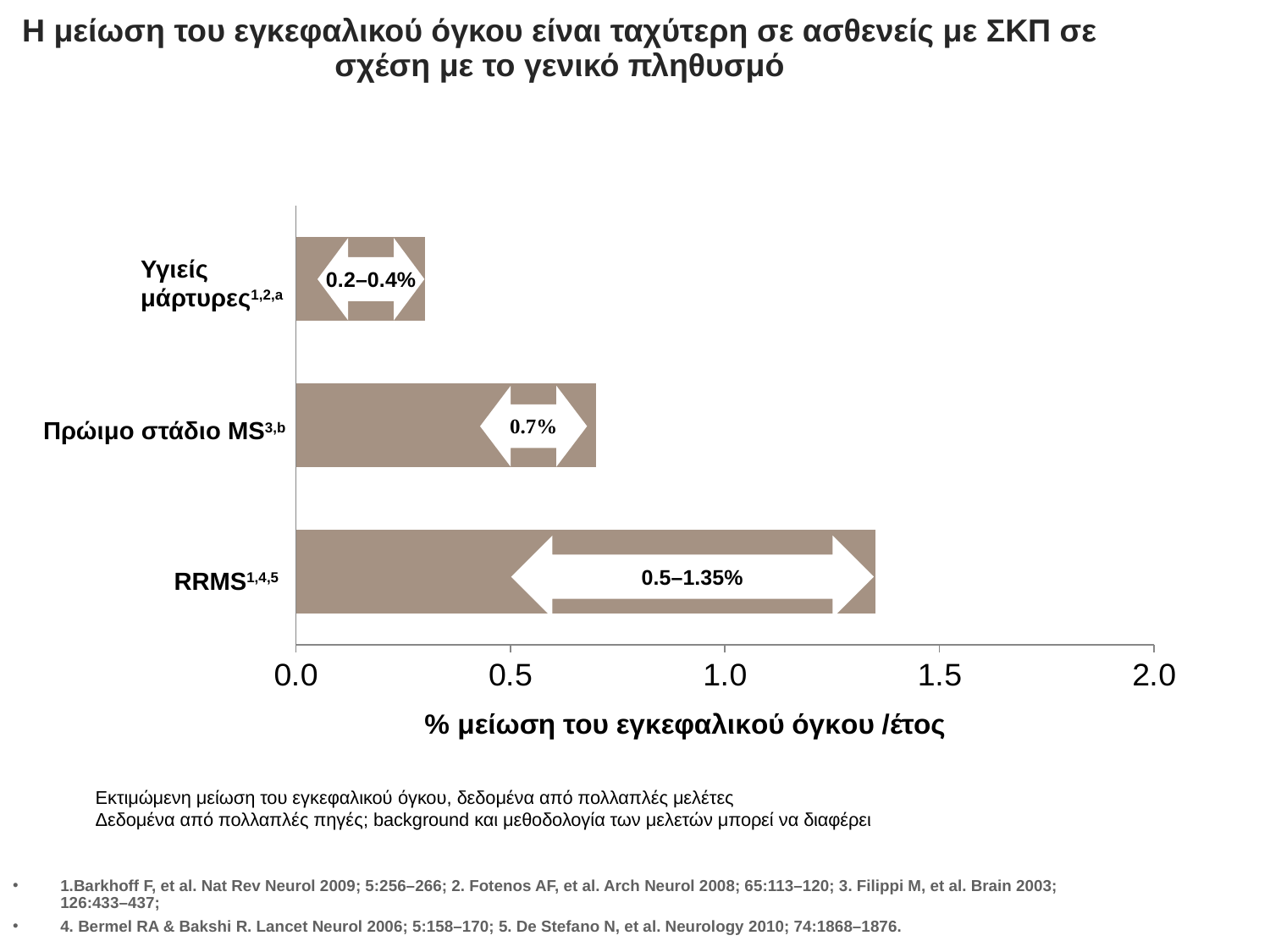
What is the data label shown on the bar for RRMS? 0.5–1.35% Which category has the shortest bar? Υγιείς μάρτυρες Is the bar for Υγιείς μάρτυρες greater or less than 0.5 on the x axis? less Is the bar for RRMS greater or less than 1.0 on the x axis? greater What is the maximum value shown on the x axis? 2.0 What is the data label shown on the bar for Υγιείς μάρτυρες? 0.2–0.4% What is the title of the x axis? % μείωση του εγκεφαλικού όγκου /έτος What kind of chart is shown on the slide? Bar chart Which category has the longest bar? RRMS What is the data label shown on the bar for Πρώιμο στάδιο MS? 0.7% Which bar is longer, Πρώιμο στάδιο MS or Υγιείς μάρτυρες? Πρώιμο στάδιο MS How many categories are plotted on the chart? 3